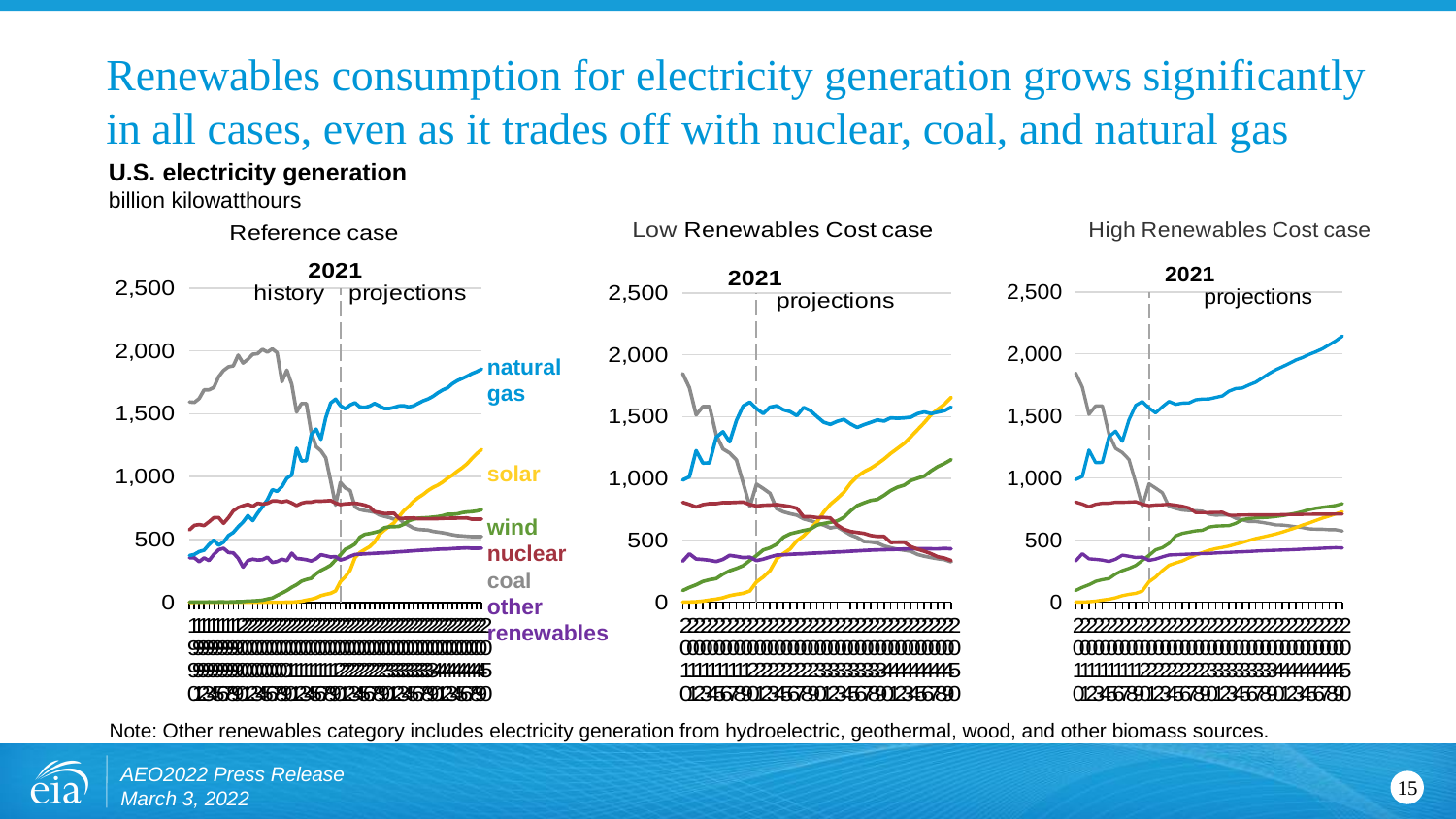
In the Reference case chart, does the solar line rise or fall over the projection period? rise In the Reference case chart, which is larger at the end of the projection period, natural gas or solar? natural gas In the Reference case chart, is the value for natural gas at the end of the projection period greater or less than 1,500? greater What kind of chart is the Reference case chart? line chart In the Reference case chart, is the value for solar at the end of the projection period greater or less than 1,000? greater In the Reference case chart, how many series are labelled? 6 How many charts are shown on the slide? 3 In the Low Renewables Cost case chart, is the value for the solar line at the end of the projection period greater or less than 1,500? greater In the Reference case chart, does the coal line rise or fall over the projection period? fall What year does the dashed vertical line separating history from projections mark in each chart? 2021 What unit is the y axis of the charts measured in? billion kilowatthours